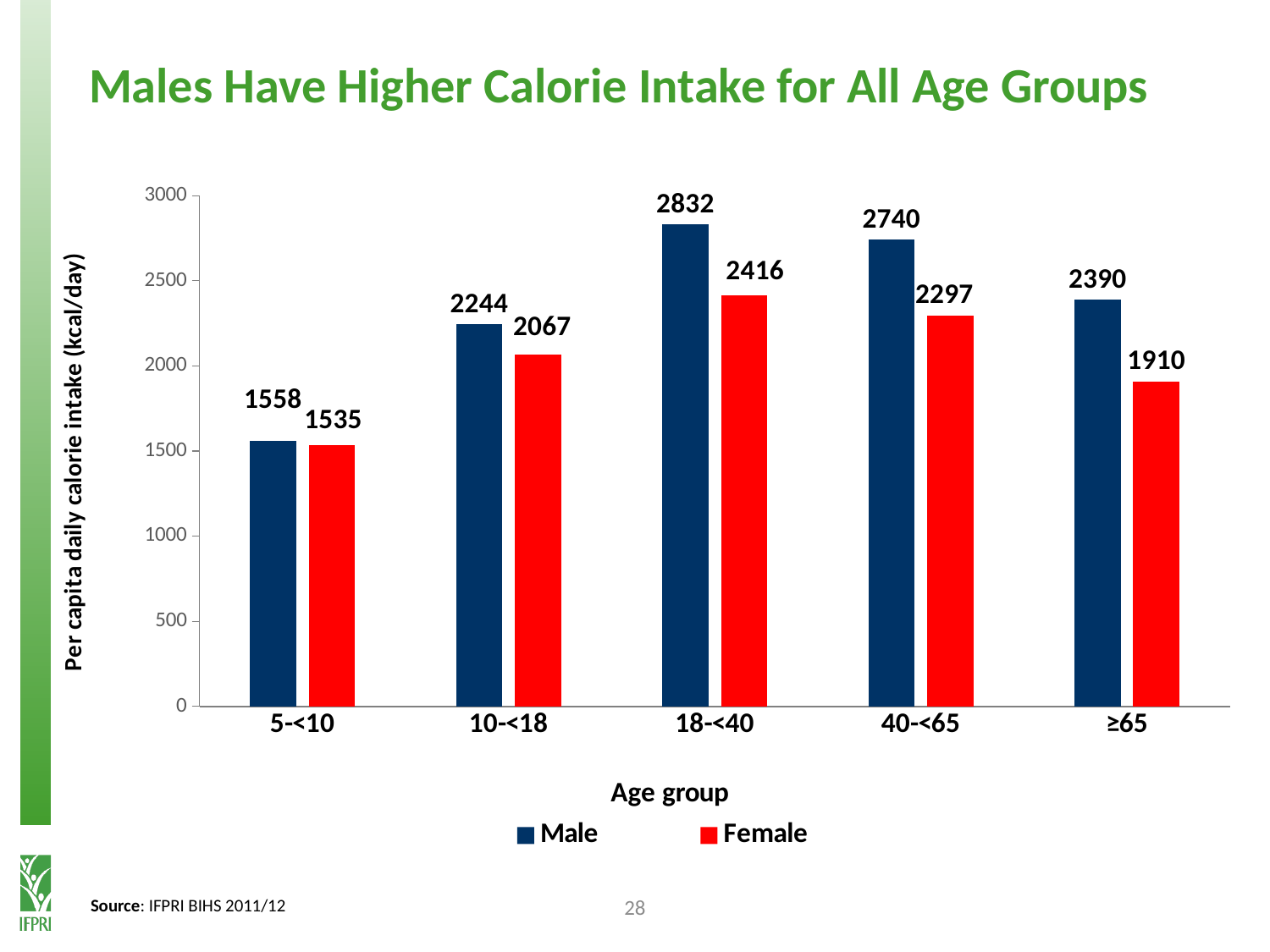
What is the per capita daily calorie intake for females in the ≥65 age group? 1910 Which age group has the lowest female calorie intake? 5-<10 What is the difference between male and female calorie intake in the ≥65 age group? 480 What is the per capita daily calorie intake for males in the 18-<40 age group? 2832 What kind of chart is shown on the slide? bar chart What is the difference between male and female calorie intake in the 18-<40 age group? 416 How many age groups are shown on the x axis? 5 How many series does the legend list? 2 Is the male calorie intake for the 40-<65 age group greater or less than 2500? greater Which is larger: the female intake for 40-<65 or the female intake for 10-<18? 40-<65 Which age group has the highest male calorie intake? 18-<40 What is the per capita daily calorie intake for females in the 10-<18 age group? 2067